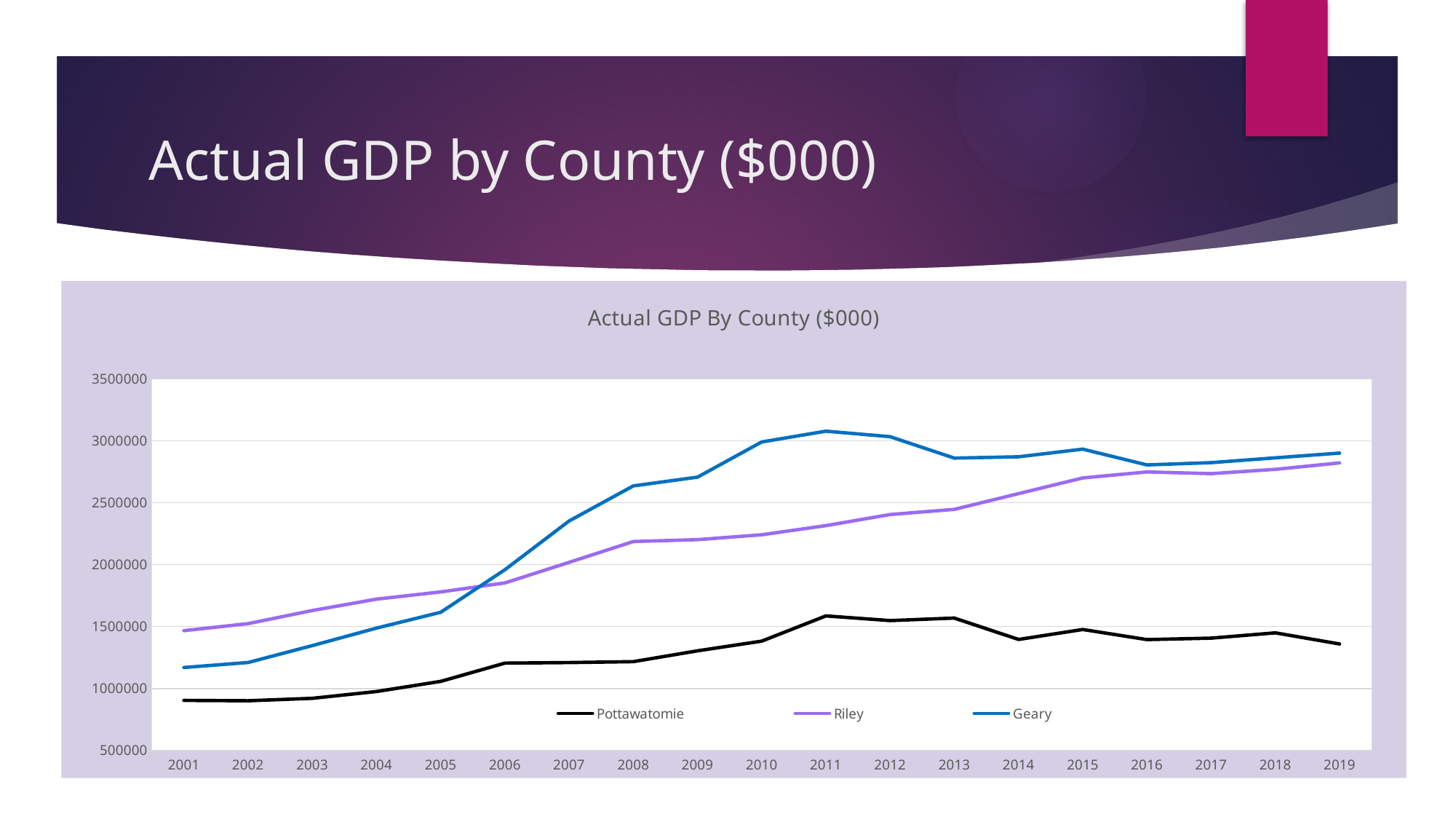
What is the title of the chart? Actual GDP By County ($000) Is the value for Pottawatomie in 2001 greater or less than 1000000? less Which county has the higher value in 2011, Geary or Riley? Geary How many series does the legend list? 3 Which county has the lowest value in 2019? Pottawatomie Is the value for Geary in 2001 greater or less than 1500000? less Which county has the higher value in 2001, Geary or Riley? Riley Does the Riley line generally rise or fall from 2001 to 2019? rise Is the value for Geary in 2011 greater or less than 3000000? greater What kind of chart is shown on the slide? line chart How many years are plotted along the x axis? 19